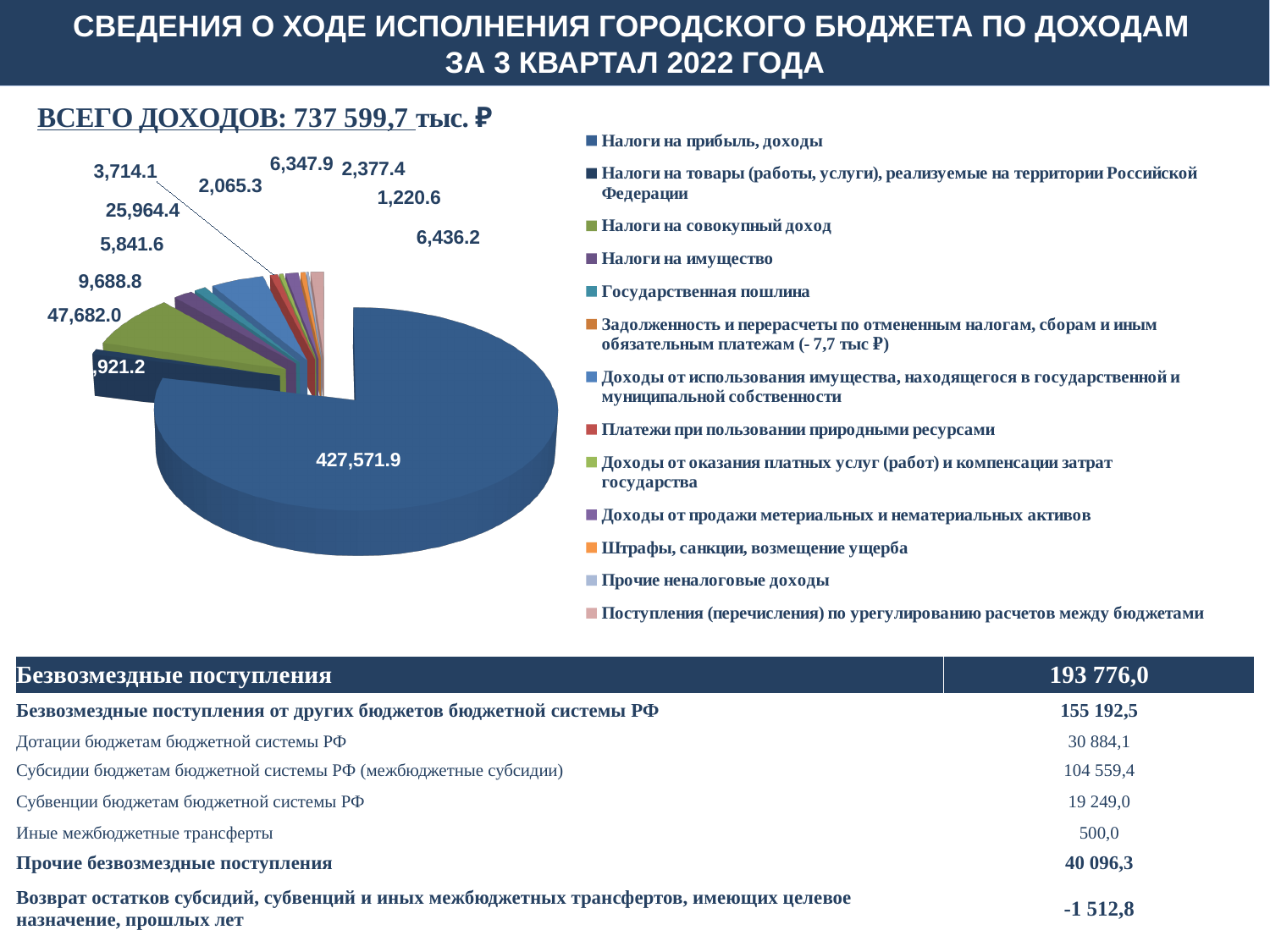
What is the smallest data label printed on the pie chart? 1,220.6 Which is larger: the slice labelled 427,571.9 or the slice labelled 47,682.0? 427,571.9 What is the first category listed in the pie chart legend? Налоги на прибыль, доходы What is the value shown for the green slice (Налоги на совокупный доход)? 47,682.0 Is the largest slice of the pie chart greater or less than half of the whole pie? greater What is the value of the largest slice in the pie chart? 427,571.9 What is the last category listed in the pie chart legend? Поступления (перечисления) по урегулированию расчетов между бюджетами What type of chart is shown on the slide? pie chart Which legend category corresponds to the largest slice of the pie chart? Налоги на прибыль, доходы What is the difference between the largest slice (427,571.9) and the slice labelled 47,682.0? 379,889.9 How many categories does the pie chart legend list? 13 What total income is stated in the heading above the pie chart? 737 599,7 тыс. ₽